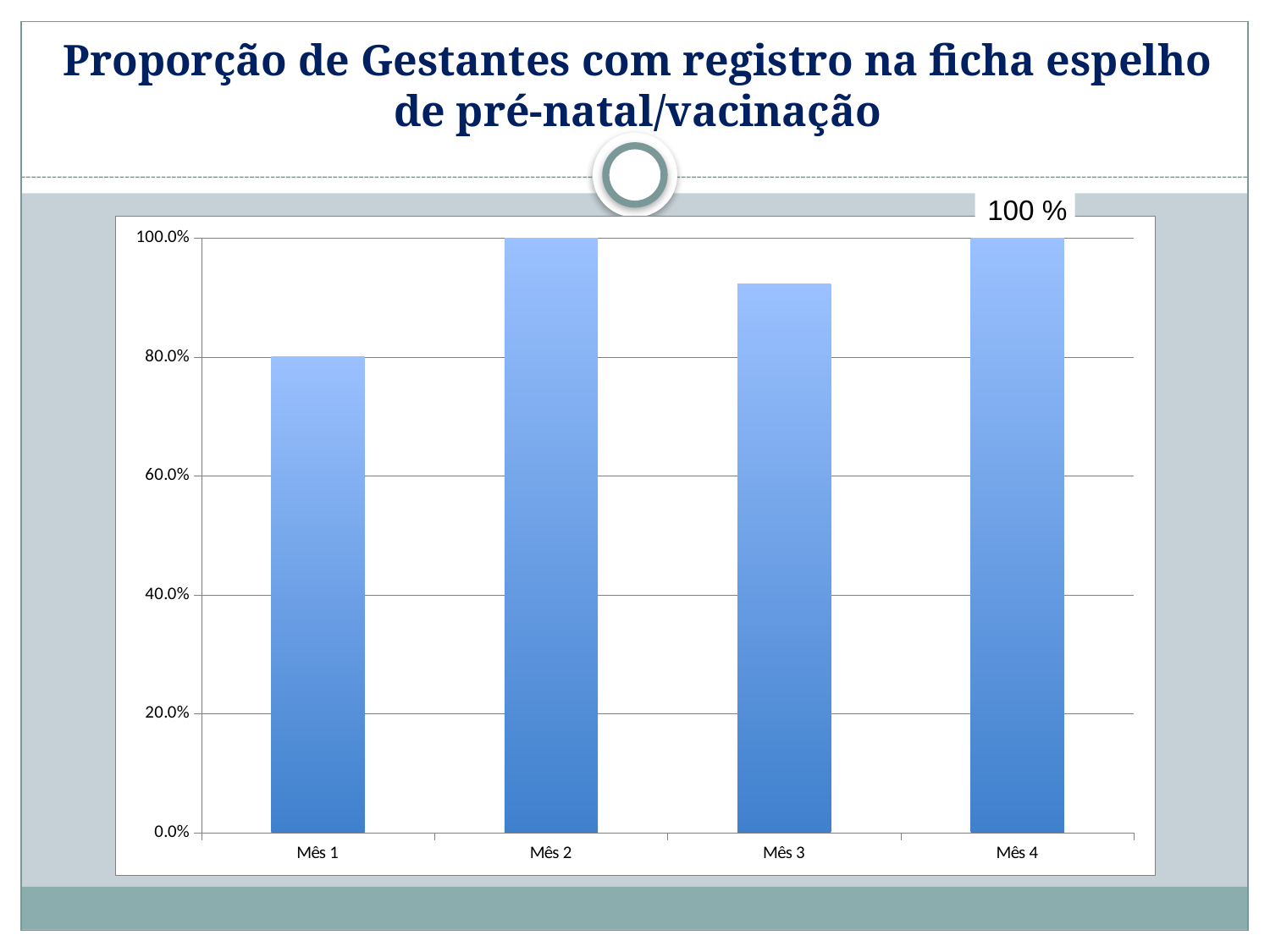
What is the title of the slide? Proporção de Gestantes com registro na ficha espelho de pré-natal/vacinação Which is larger, the value for Mês 1 or the value for Mês 3? Mês 3 What is the difference between the values for Mês 2 and Mês 1? 20.0% What is the value for Mês 1? 80.0% What is the value for Mês 2? 100.0% Which month has the lowest value? Mês 1 Is the value for Mês 3 greater or less than 80.0%? greater How many months are shown on the x axis? 4 Is the value for Mês 3 greater or less than 100.0%? less Does the value rise or fall from Mês 1 to Mês 2? rise What is the value for Mês 4? 100.0% What kind of chart is shown on the slide? bar chart